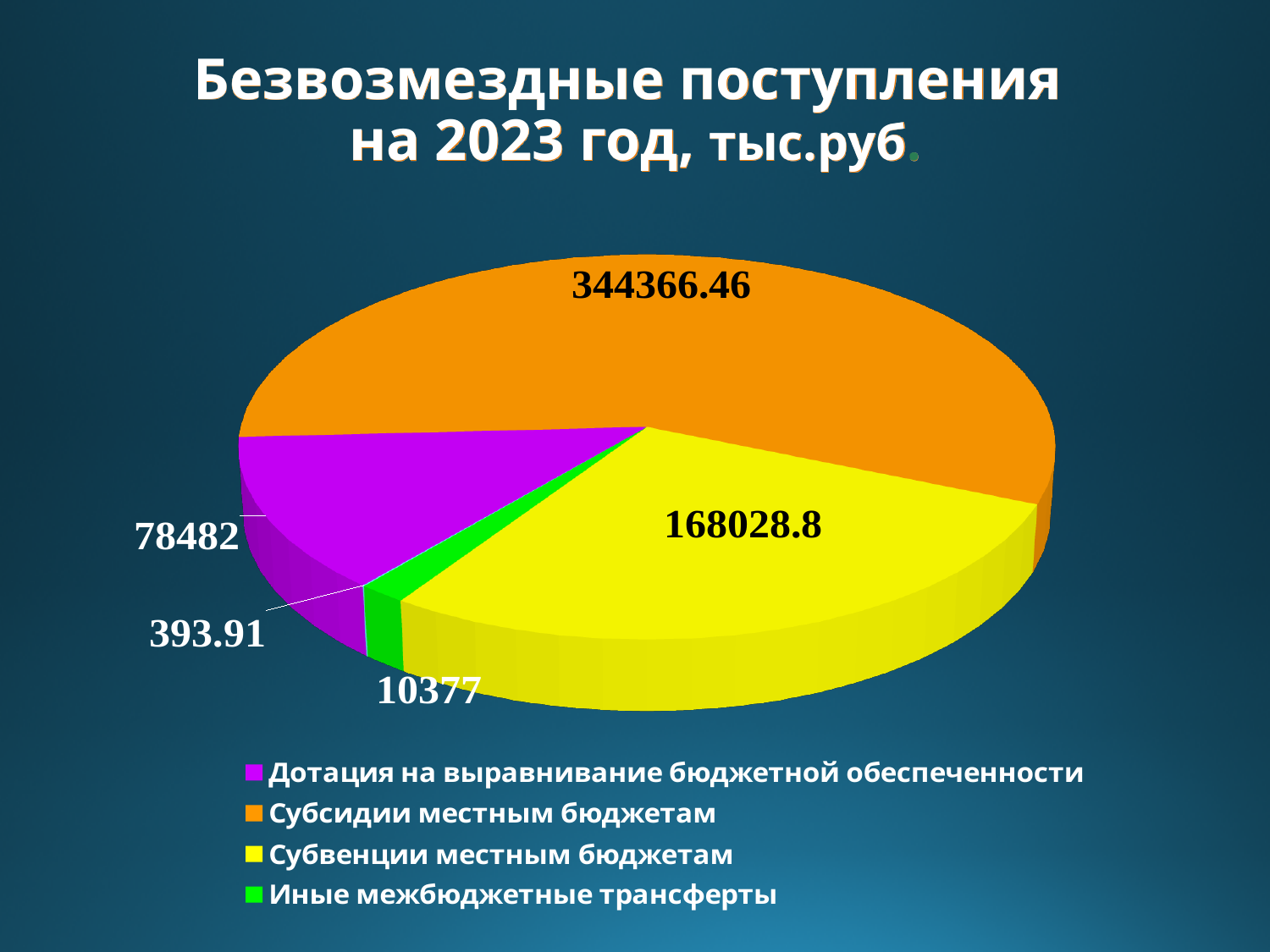
What kind of chart is shown on the slide? Pie chart What is the value for Субвенции местным бюджетам? 168028.8 What is the value for Иные межбюджетные трансферты? 10377 What is the difference between the values for Субсидии местным бюджетам and Субвенции местным бюджетам? 176337.66 Which category has the largest slice of the pie? Субсидии местным бюджетам What is the value for Дотация на выравнивание бюджетной обеспеченности? 78482 What colour is the slice for Субвенции местным бюджетам? Yellow What is the difference between the values for Дотация на выравнивание бюджетной обеспеченности and Иные межбюджетные трансферты? 68105 Which is larger: Субвенции местным бюджетам or Дотация на выравнивание бюджетной обеспеченности? Субвенции местным бюджетам How many categories does the legend list? 4 What is the value for Субсидии местным бюджетам? 344366.46 What is the title of the chart? Безвозмездные поступления на 2023 год, тыс.руб.